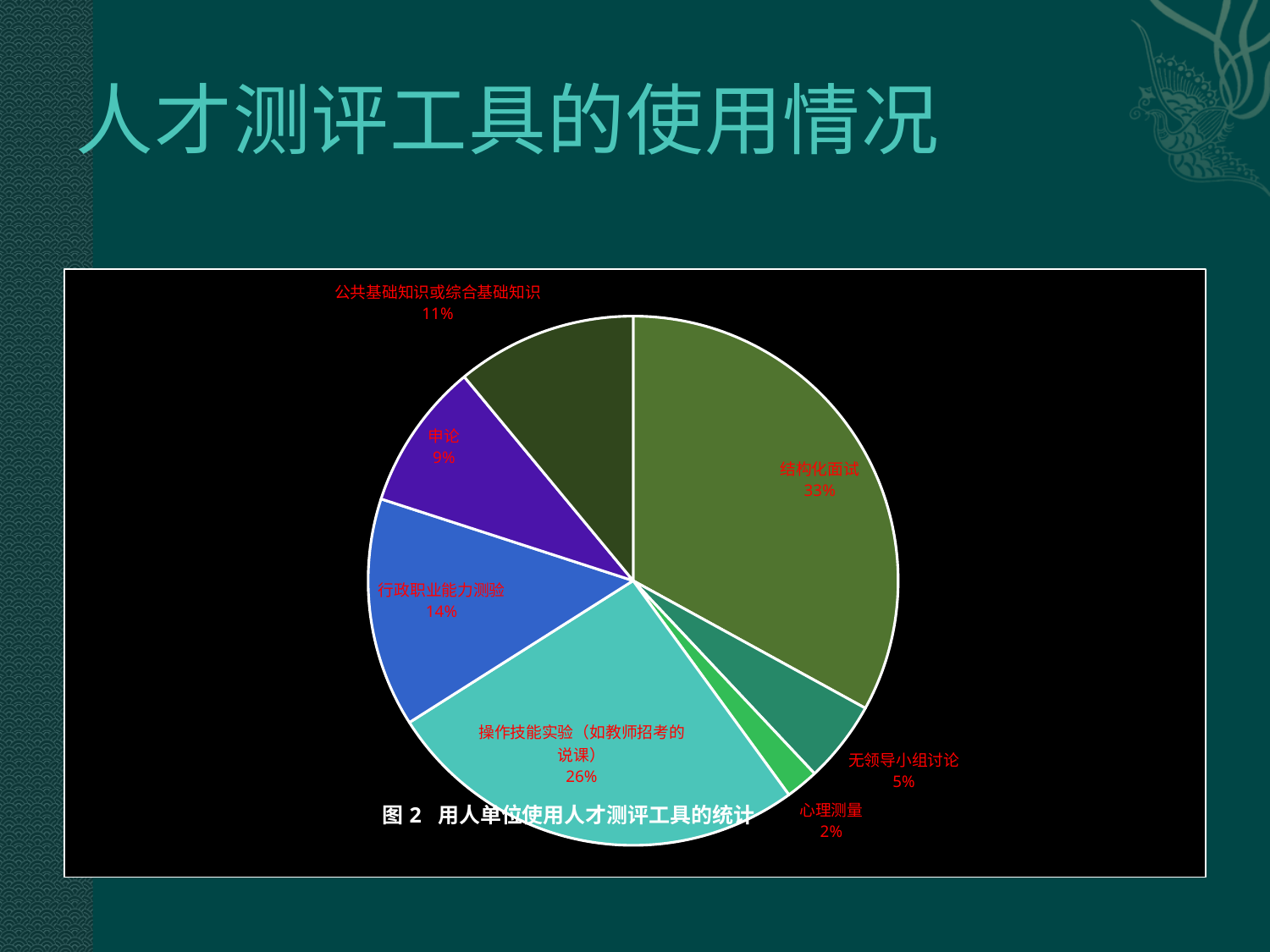
What percentage is shown for 申论? 9% What is the caption printed below the pie chart? 图 2 用人单位使用人才测评工具的统计 What is the difference in percentage points between 结构化面试 and 操作技能实验（如教师招考的说课）? 7 Which category has the largest slice of the pie? 结构化面试 What type of chart is shown on the slide? pie chart Which is larger, the share for 公共基础知识或综合基础知识 or the share for 申论? 公共基础知识或综合基础知识 What share of the pie does 结构化面试 account for? 33% Which category has the smallest slice of the pie? 心理测量 What share does 无领导小组讨论 have in the pie chart? 5% What is the value labelled for 行政职业能力测验? 14% What percentage is shown for 操作技能实验（如教师招考的说课）? 26% How many categories (slices) does the pie chart contain? 7